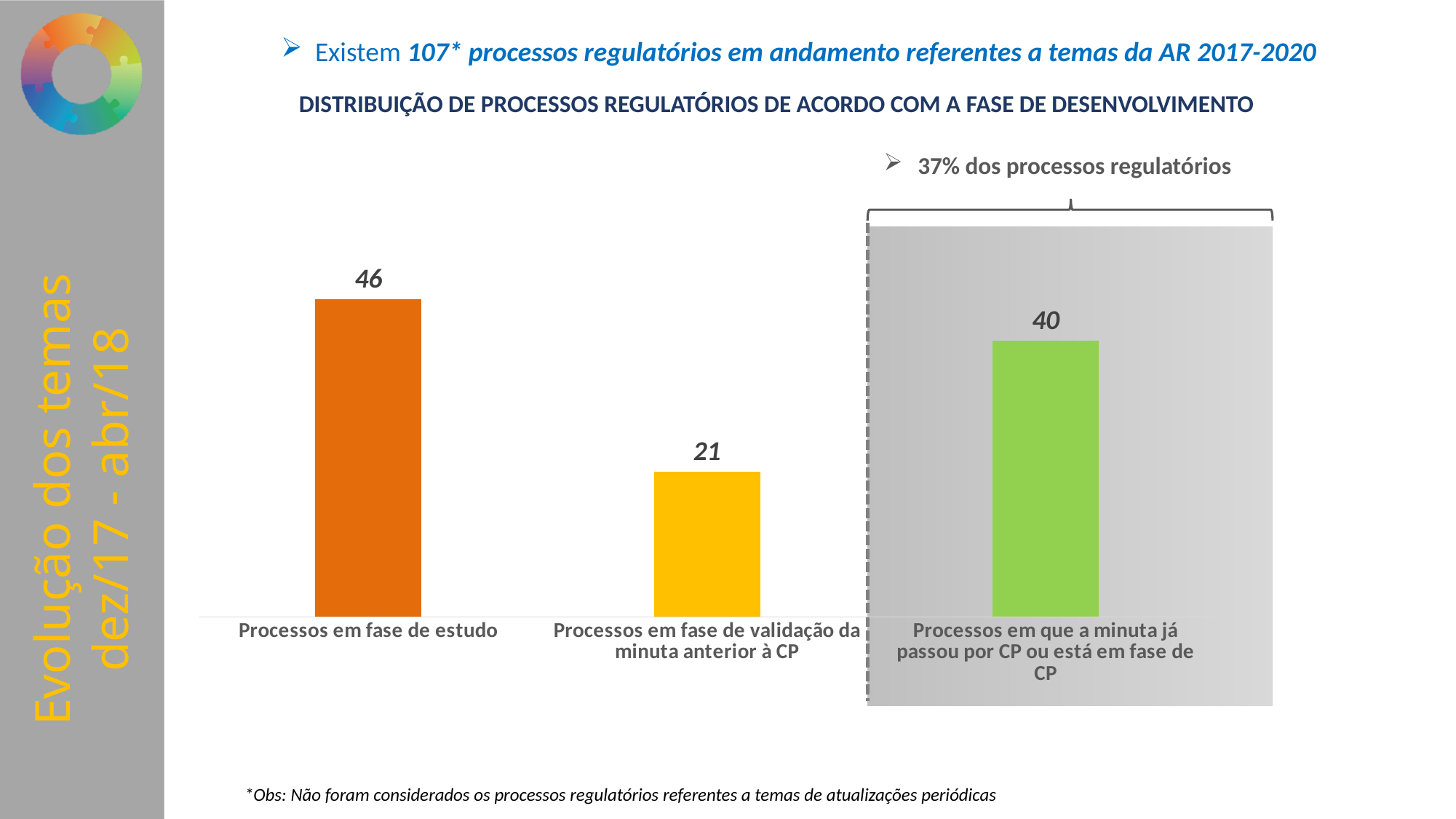
Which category has the highest value? Processos em fase de estudo What is the difference between the values for "Processos em fase de estudo" and "Processos em fase de validação da minuta anterior à CP"? 25 What is the title of the chart? DISTRIBUIÇÃO DE PROCESSOS REGULATÓRIOS DE ACORDO COM A FASE DE DESENVOLVIMENTO What kind of chart is shown on the slide? Bar chart What is the value for "Processos em fase de validação da minuta anterior à CP"? 21 What is the value for "Processos em que a minuta já passou por CP ou está em fase de CP"? 40 How many categories are shown in the chart? 3 What is the value for "Processos em fase de estudo"? 46 What is the difference between the values for "Processos em fase de estudo" and "Processos em que a minuta já passou por CP ou está em fase de CP"? 6 What percentage of regulatory processes does the highlighted box on the right of the chart represent? 37% Which category has the lowest value? Processos em fase de validação da minuta anterior à CP Which is larger: the value for "Processos em que a minuta já passou por CP ou está em fase de CP" or the value for "Processos em fase de validação da minuta anterior à CP"? Processos em que a minuta já passou por CP ou está em fase de CP